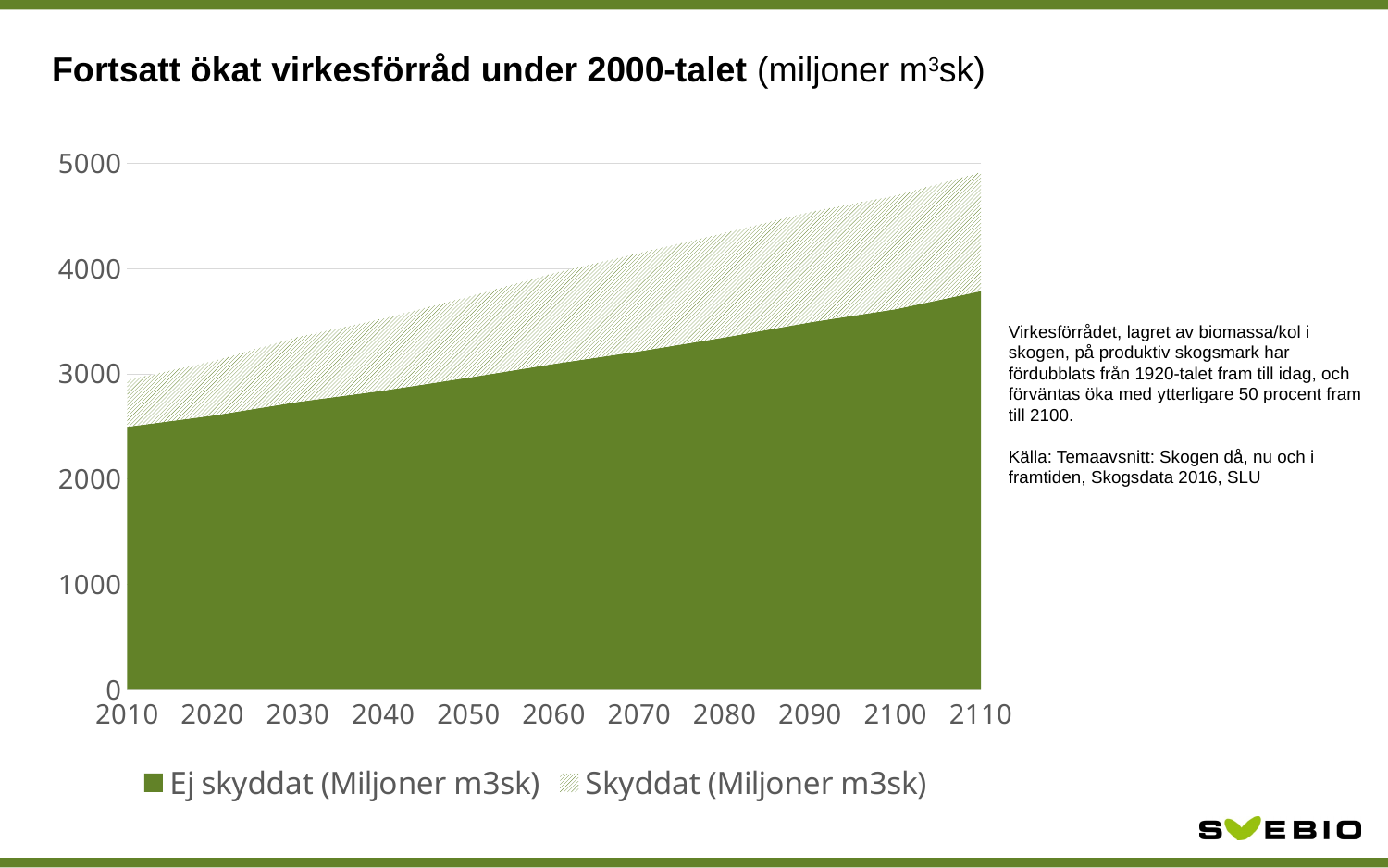
How many year labels are shown on the x axis? 11 What is the title of the chart? Fortsatt ökat virkesförråd under 2000-talet (miljoner m³sk) Is the combined total of Ej skyddat and Skyddat in 2110 greater or less than 4000? greater What are the two series named in the legend? Ej skyddat (Miljoner m3sk) and Skyddat (Miljoner m3sk) Is the value for Ej skyddat in 2010 greater or less than 2000? greater Is the value for Ej skyddat in 2010 greater or less than 3000? less How many series does the legend list? 2 In 2110, which series has the larger value, Ej skyddat or Skyddat? Ej skyddat Do the values for Ej skyddat rise or fall from 2010 to 2110? Rise What kind of chart is shown on the slide? Stacked area chart